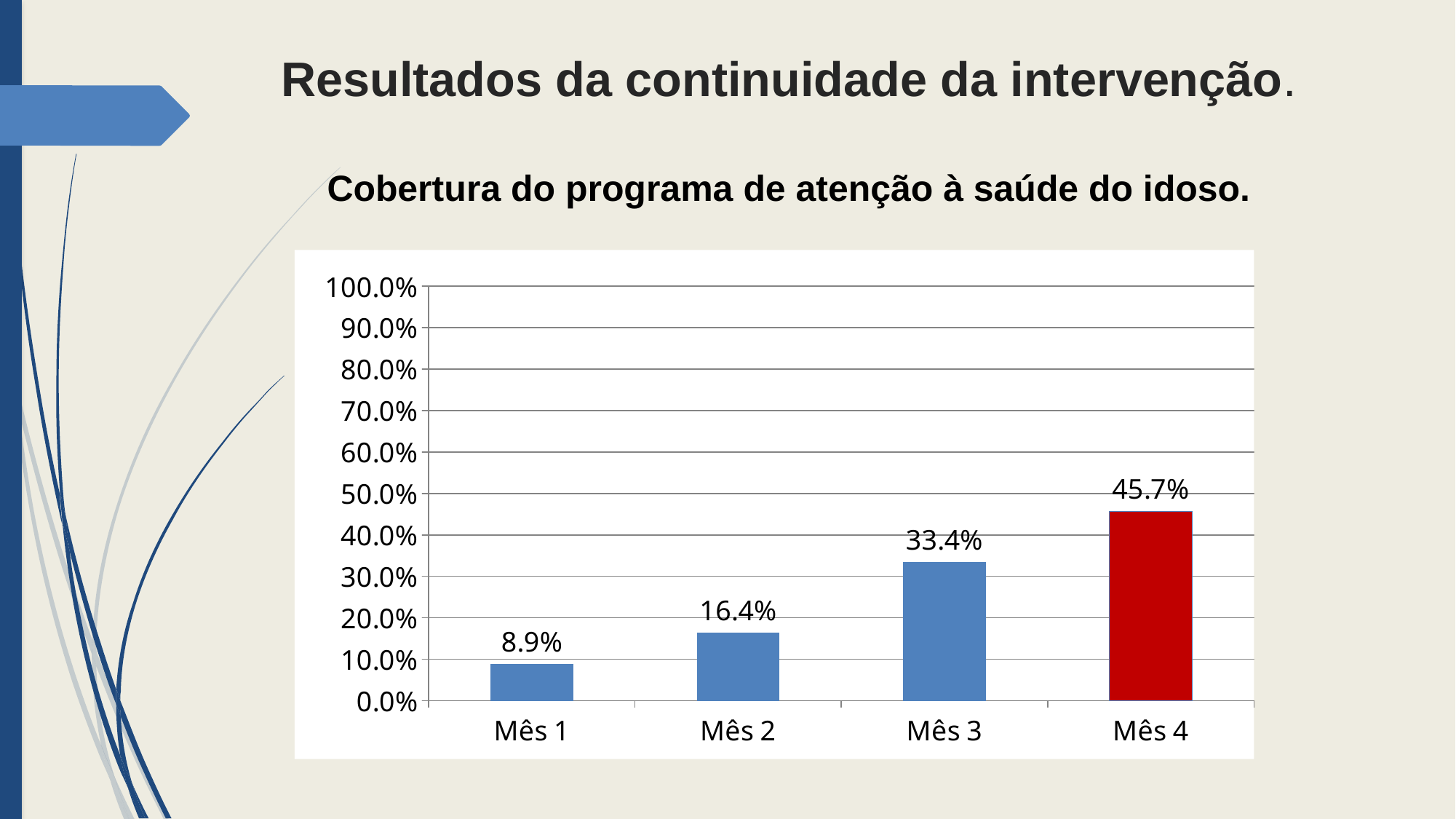
What is the difference between the values for Mês 4 and Mês 3? 12.3% Which is larger, the value for Mês 2 or the value for Mês 3? Mês 3 What kind of chart is shown? bar chart What is the value for Mês 1? 8.9% What is the value for Mês 4? 45.7% Is the value for Mês 4 greater or less than 50.0%? less What is the value for Mês 3? 33.4% What is the difference between the values for Mês 2 and Mês 1? 7.5% Which month has the highest value? Mês 4 Do the values rise or fall from Mês 1 to Mês 4? rise How many months are shown on the x axis? 4 Which month has the lowest value? Mês 1